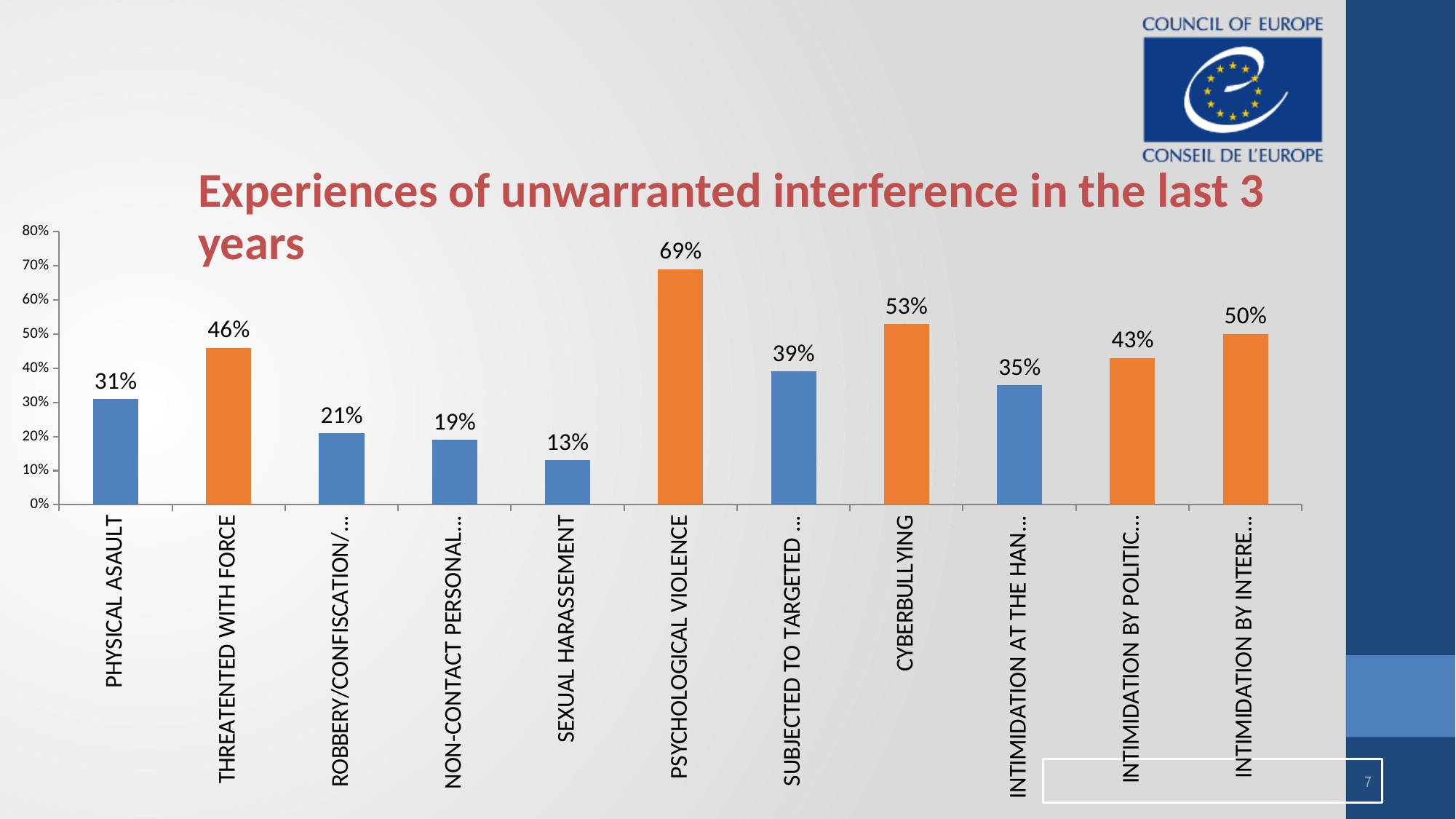
Which category has the highest value? Psychological violence Which category has the lowest value? Sexual harassement What is the title of the chart? Experiences of unwarranted interference in the last 3 years What is the value for Threatened with force? 46% Which is larger, the value for Threatened with force or the value for Physical asault? Threatened with force How many categories are shown in the chart? 11 What is the value for Psychological violence? 69% What is the value for Physical asault? 31% What is the difference between the values for Psychological violence and Cyberbullying? 16% What is the value for Sexual harassement? 13% What kind of chart is shown on the slide? Bar chart What is the value for Cyberbullying? 53%